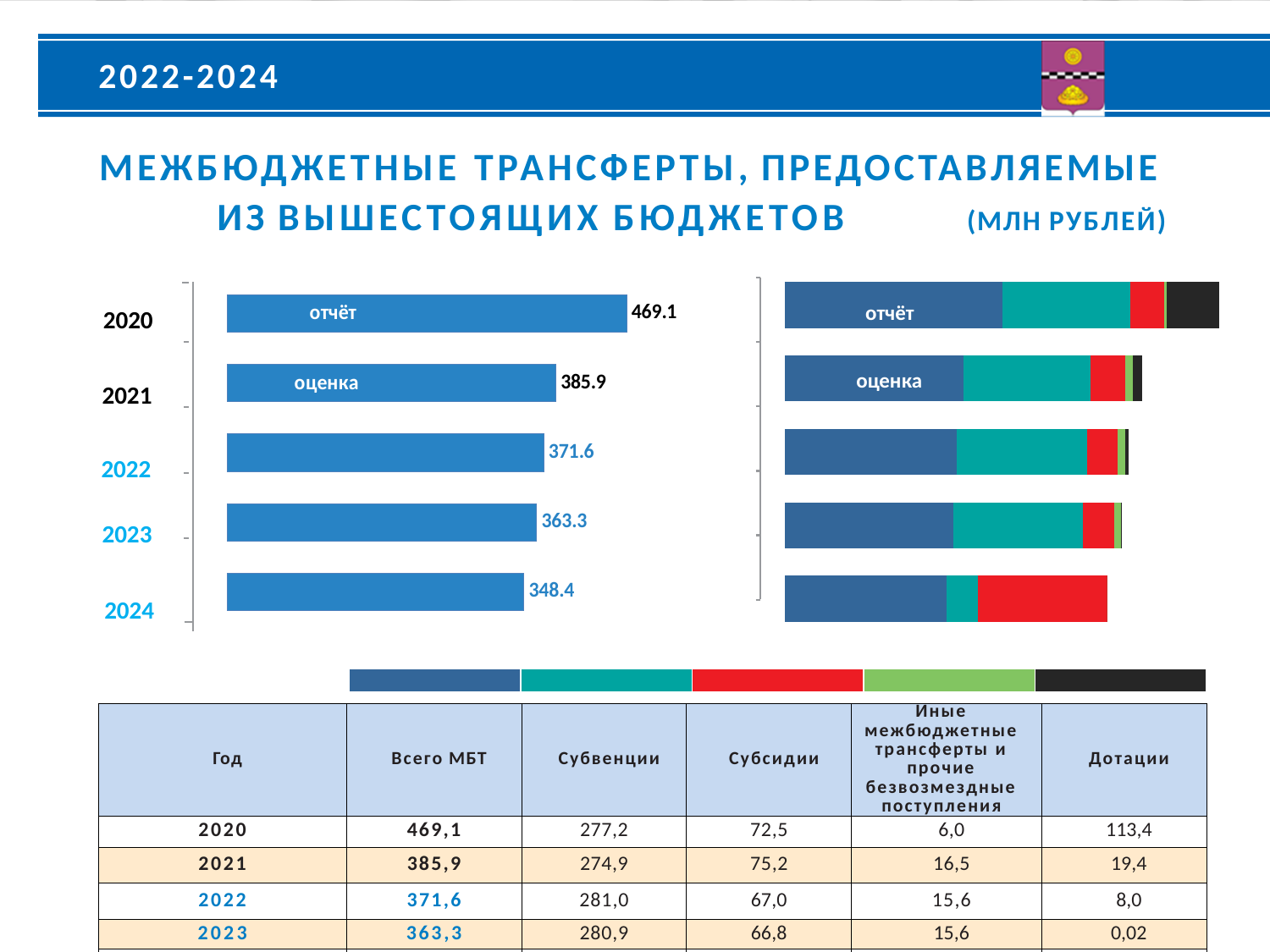
In the left bar chart, what is the value for 2022? 371.6 In the left bar chart, what label is written on the 2020 bar? отчёт In the left bar chart, what is the difference between the values for 2023 and 2024? 14.9 How many years are shown in the left bar chart? 5 What kind of chart is the chart on the left? bar chart In the left bar chart, what is the value for 2024? 348.4 In the left bar chart, what is the difference between the values for 2020 and 2021? 83.2 In the left bar chart, which is larger, the value for 2021 or the value for 2022? 2021 In the left bar chart, which year has the lowest value? 2024 In the left bar chart, which year has the highest value? 2020 In the left bar chart, what is the value for 2020? 469.1 In the left bar chart, do the values rise or fall from 2020 to 2024? fall